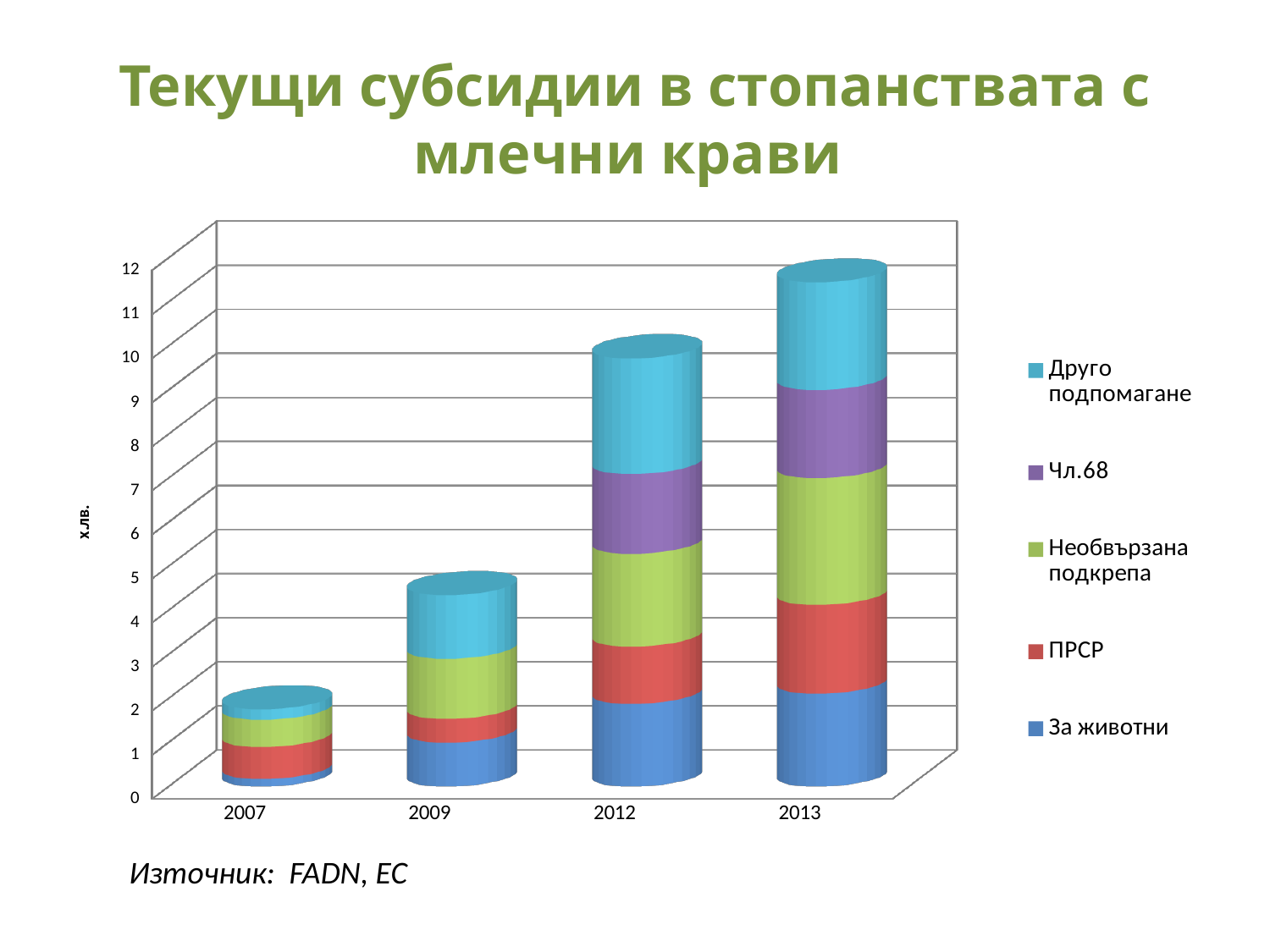
What unit is shown on the y axis of the chart? х.лв. What kind of chart is shown on the slide? Stacked bar chart Which year has a larger total, 2009 or 2012? 2012 Is the total value for 2007 greater or less than 3? less Is the total value for 2013 greater or less than 10? greater Is the total value for 2012 greater or less than 8? greater Which year has the highest total subsidies in the chart? 2013 In which years does the Чл.68 series appear in the stacked bars? 2012 and 2013 Which year has the lowest total subsidies in the chart? 2007 How many years are shown on the x axis of the chart? 4 How many series does the chart legend list? 5 Do the total subsidies rise or fall from 2007 to 2013? Rise